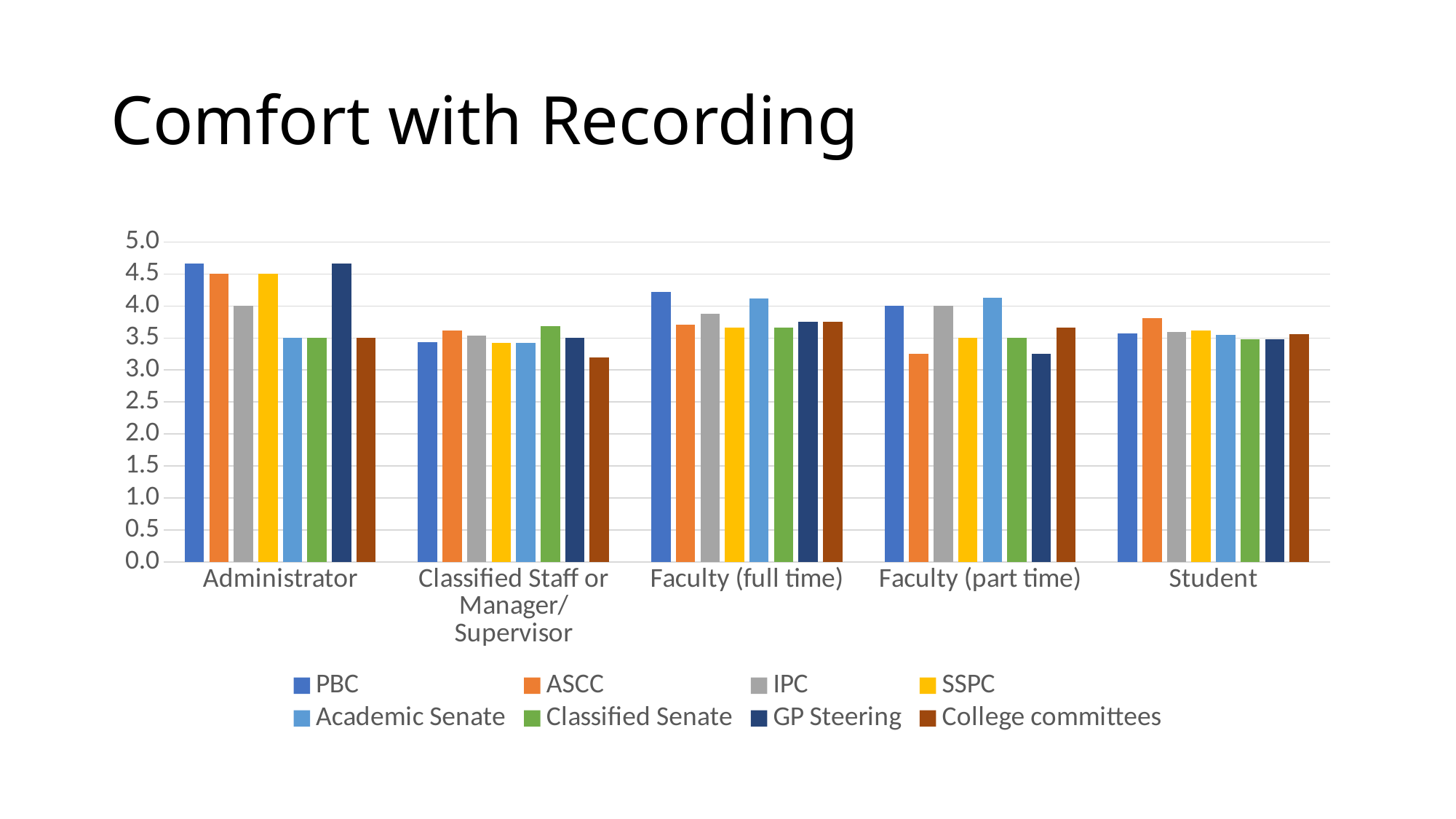
How many categories are shown along the x axis? 5 Is the value for PBC in the Administrator category greater or less than 4.0? greater In the Administrator category, which is larger: PBC or IPC? PBC Is the value for College committees in the Classified Staff or Manager/Supervisor category greater or less than 3.5? less Which series has the lowest value in the Classified Staff or Manager/Supervisor category? College committees Is the value for IPC in the Administrator category greater or less than 3.5? greater What kind of chart is shown on the slide? bar chart What is the title of the slide? Comfort with Recording Which series has the highest value in the Student category? ASCC How many series does the legend list? 8 In the Faculty (full time) category, which is larger: PBC or ASCC? PBC